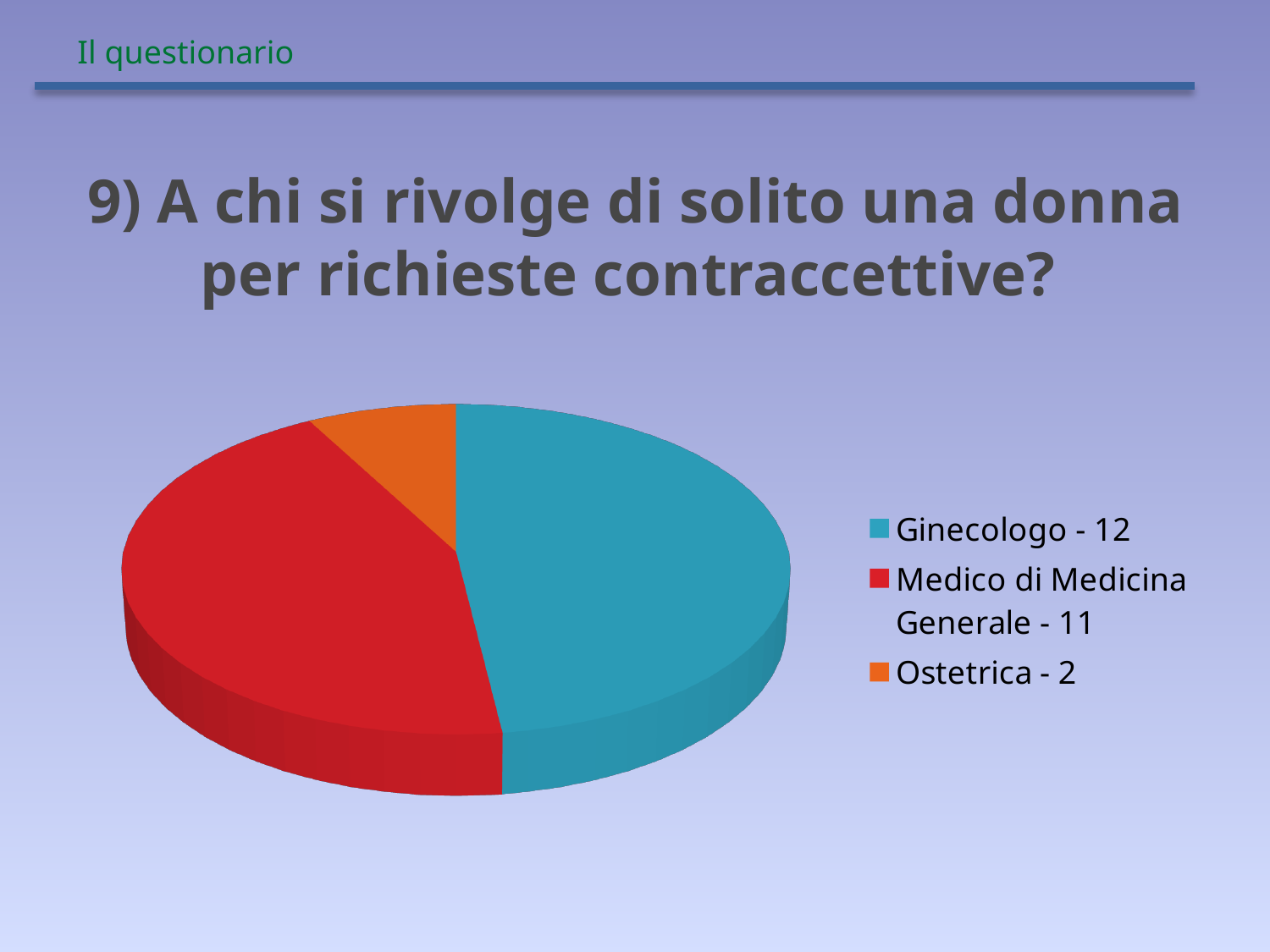
What colour is the Medico di Medicina Generale slice? red How many categories does the pie chart have? 3 What is the value for Ostetrica? 2 What is the difference between the values for Ginecologo and Medico di Medicina Generale? 1 Which is larger, the value for Ginecologo or the value for Ostetrica? Ginecologo What is the difference between the values for Medico di Medicina Generale and Ostetrica? 9 What kind of chart is shown on the slide? pie chart What share of the pie does Ostetrica represent? 8% What is the value for Ginecologo? 12 What is the value for Medico di Medicina Generale? 11 Which category has the highest value? Ginecologo Which category has the lowest value? Ostetrica